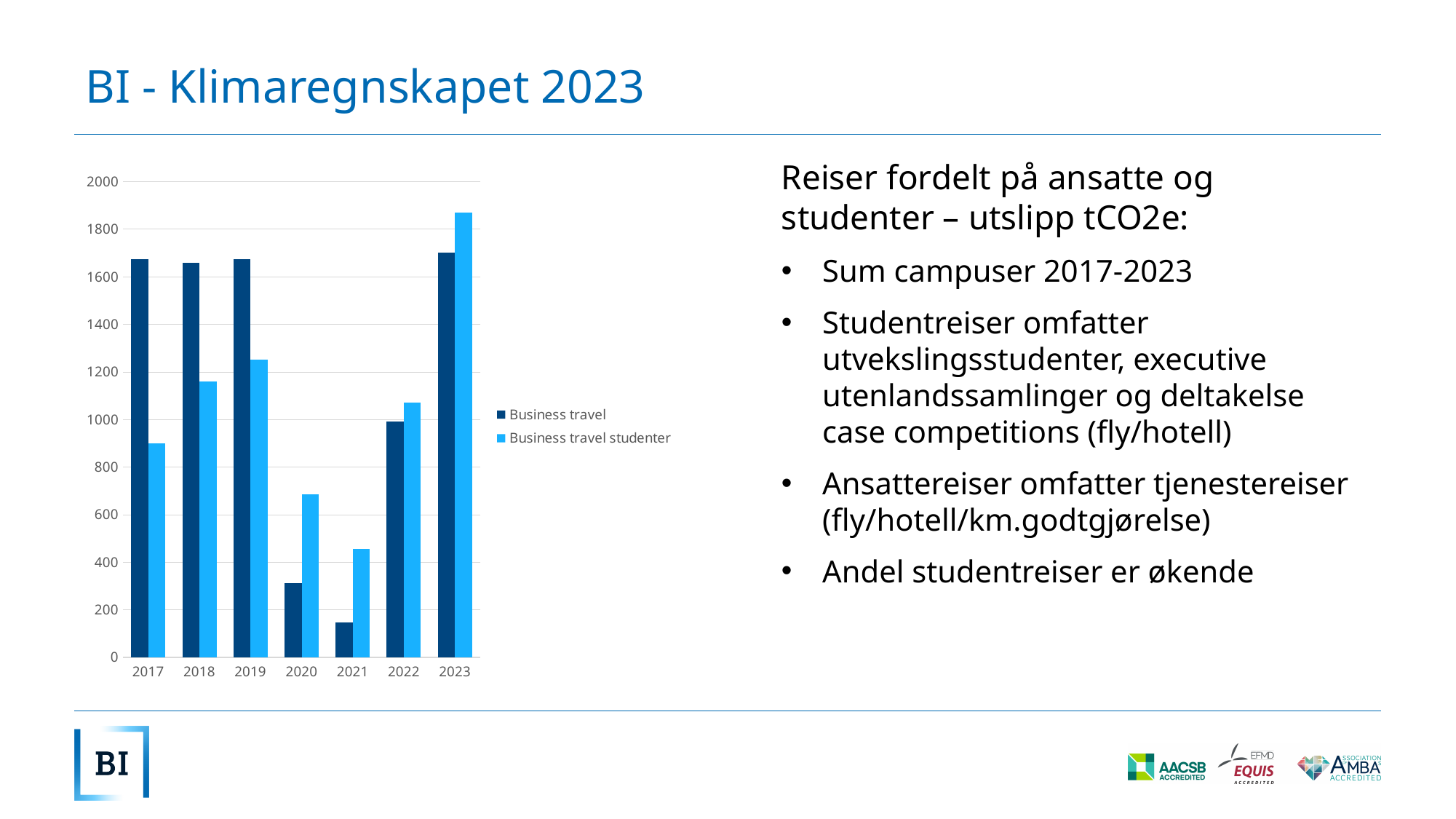
How many years are shown on the x axis of the chart? 7 Which year has the lowest value for Business travel? 2021 Which year has the lowest value for Business travel studenter? 2021 In 2017, which series has the larger value: Business travel or Business travel studenter? Business travel Is the value for Business travel studenter in 2020 greater or less than 600? greater Is the value for Business travel in 2021 greater or less than 200? less Do the values for Business travel studenter rise or fall from 2021 to 2023? rise Which year has the highest value for Business travel studenter? 2023 Is the value for Business travel studenter in 2023 greater or less than 1800? greater How many series does the chart legend list? 2 What kind of chart is shown on the slide? bar chart In 2023, which series has the larger value: Business travel or Business travel studenter? Business travel studenter